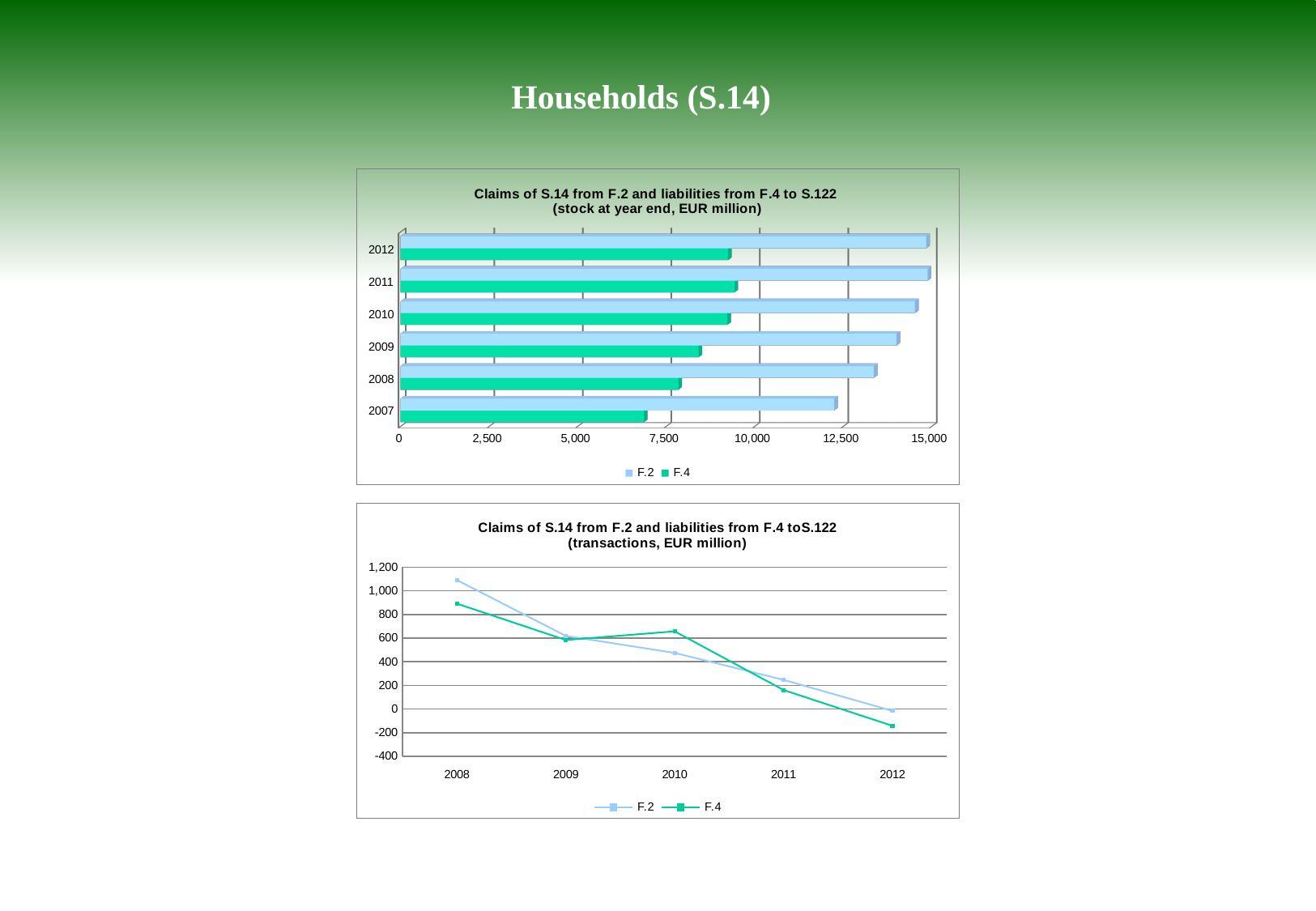
What kind of chart is the top chart, 'Claims of S.14 from F.2 and liabilities from F.4 to S.122 (stock at year end, EUR million)'? bar chart In the top chart (stock at year end), is the F.2 value for 2012 greater or less than 12,500? greater In the bottom chart (transactions), is the F.4 value for 2012 greater or less than 0? less In the bottom chart (transactions), how many series does the legend list? 2 In the bottom chart (transactions), is the F.2 value for 2008 greater or less than 1,000? greater In the top chart (stock at year end), how many years are shown on the vertical axis? 6 In the top chart (stock at year end), which year has the lowest F.2 value? 2007 In the bottom chart (transactions), which series has the larger value in 2010, F.2 or F.4? F.4 What kind of chart is the bottom chart, 'Claims of S.14 from F.2 and liabilities from F.4 toS.122 (transactions, EUR million)'? line chart In the bottom chart (transactions), do the F.2 values rise or fall from 2008 to 2012? fall In the top chart (stock at year end), which series has the larger value in 2010, F.2 or F.4? F.2